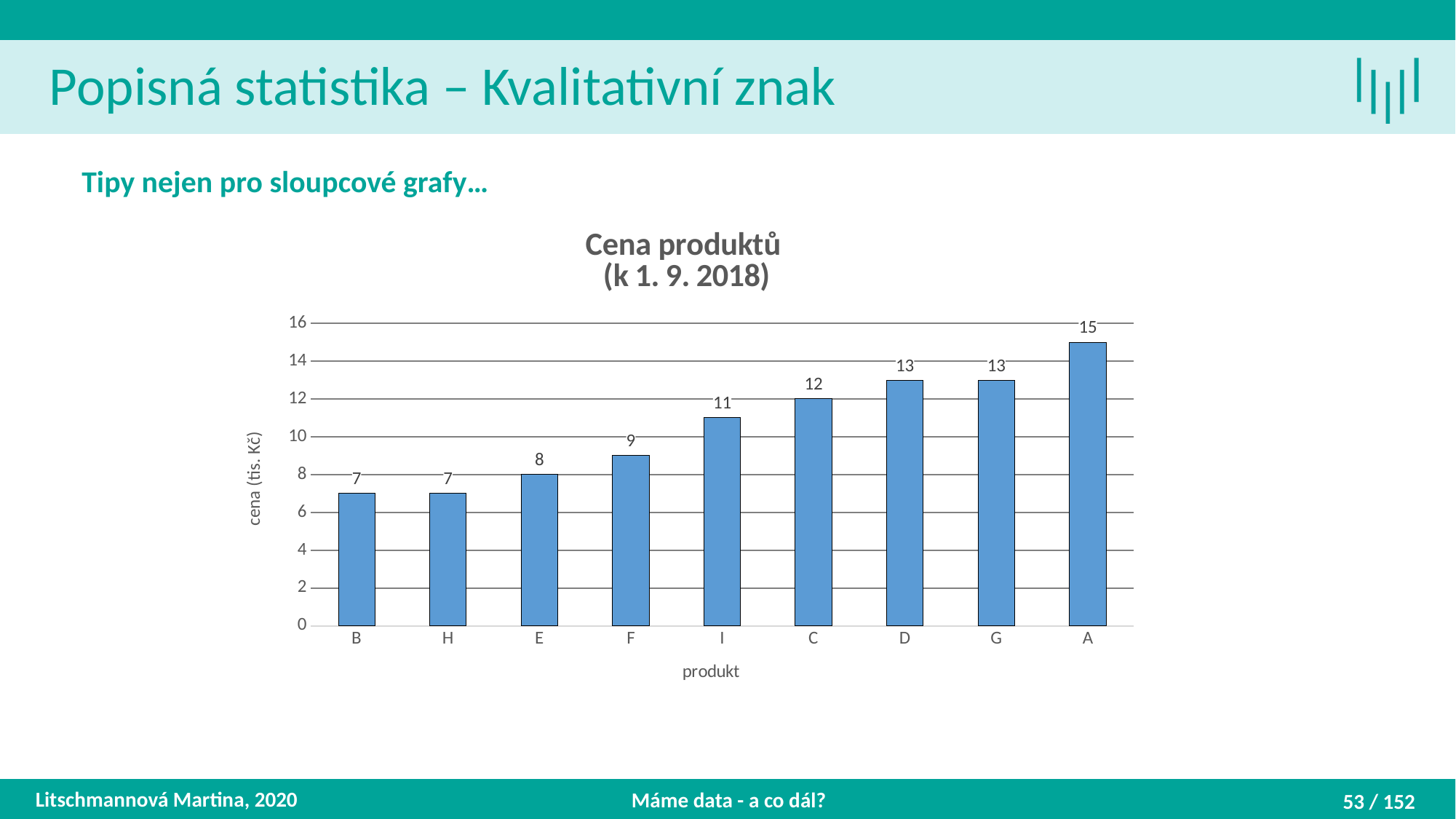
What kind of chart is shown on the slide? bar chart Do the values rise or fall from left to right along the x axis? rise Is the value for product G greater or less than 10? greater What is the title of the chart? Cena produktů (k 1. 9. 2018) Which product has the highest price? A What is the label of the y axis? cena (tis. Kč) What is the difference between the values for product A and product F? 6 Which is larger, the value for product D or the value for product I? D How many products are shown on the x axis? 9 What is the value for product C? 12 What is the value for product E? 8 What is the value for product I? 11